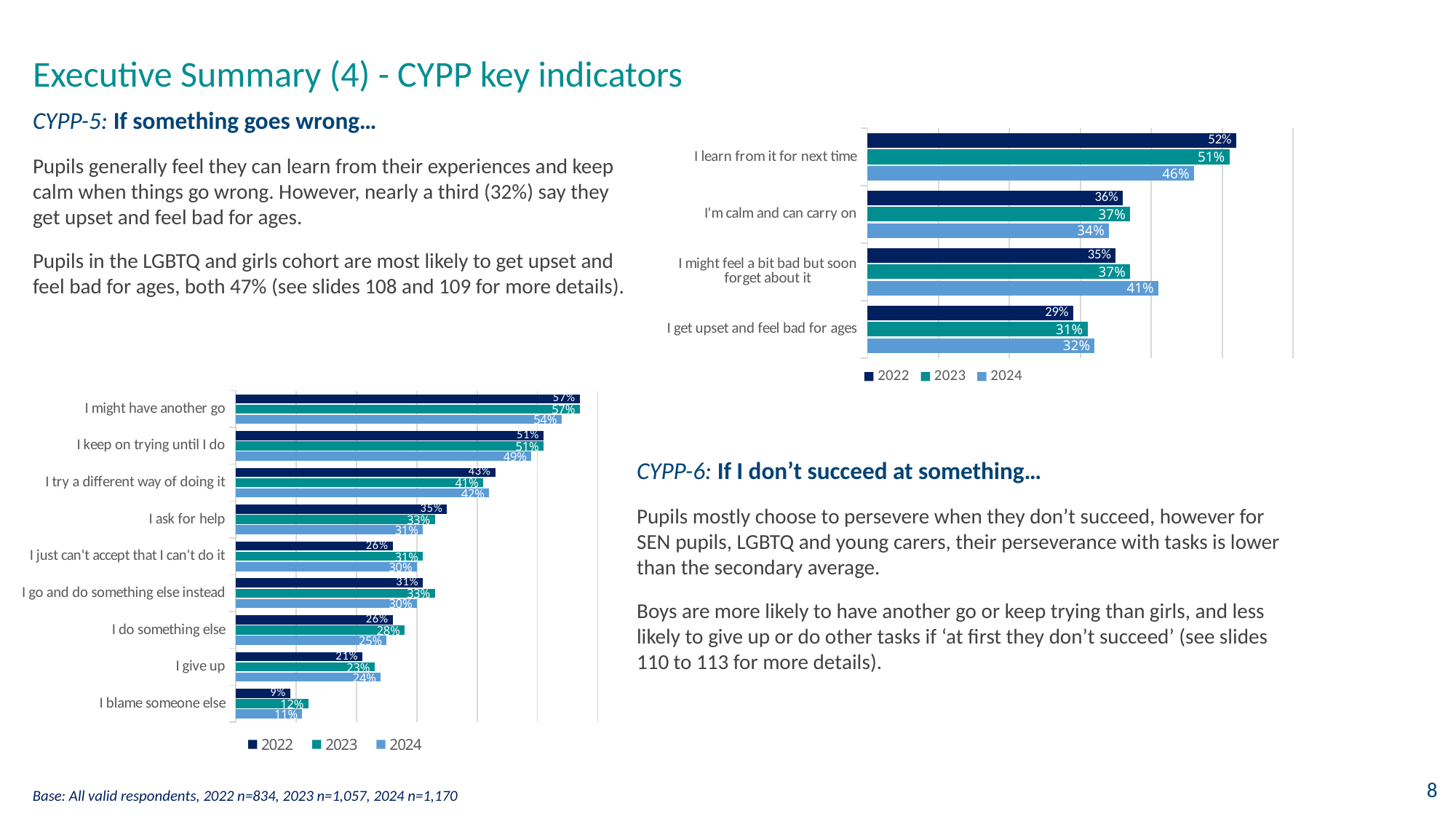
In the top-right chart, which category has the highest 2022 value? I learn from it for next time In the top-right chart, what is the difference between the 2022 and 2024 values for 'I learn from it for next time'? 6% In the bottom-left chart, do the values for 'I give up' rise or fall from 2022 to 2024? rise In the bottom-left chart, what is the 2024 value for 'I give up'? 24% In the bottom-left chart, how many categories are shown? 9 In the bottom-left chart, which category has the lowest 2022 value? I blame someone else In the top-right chart, what is the 2022 value for 'I get upset and feel bad for ages'? 29% In the top-right chart, how many series does the legend list? 3 In the top-right chart, what is the 2024 value for 'I learn from it for next time'? 46% What type of chart is the bottom-left chart? bar chart In the bottom-left chart, which is larger: the 2022 value for 'I ask for help' or the 2022 value for 'I go and do something else instead'? I ask for help In the bottom-left chart, what is the 2023 value for 'I blame someone else'? 12%